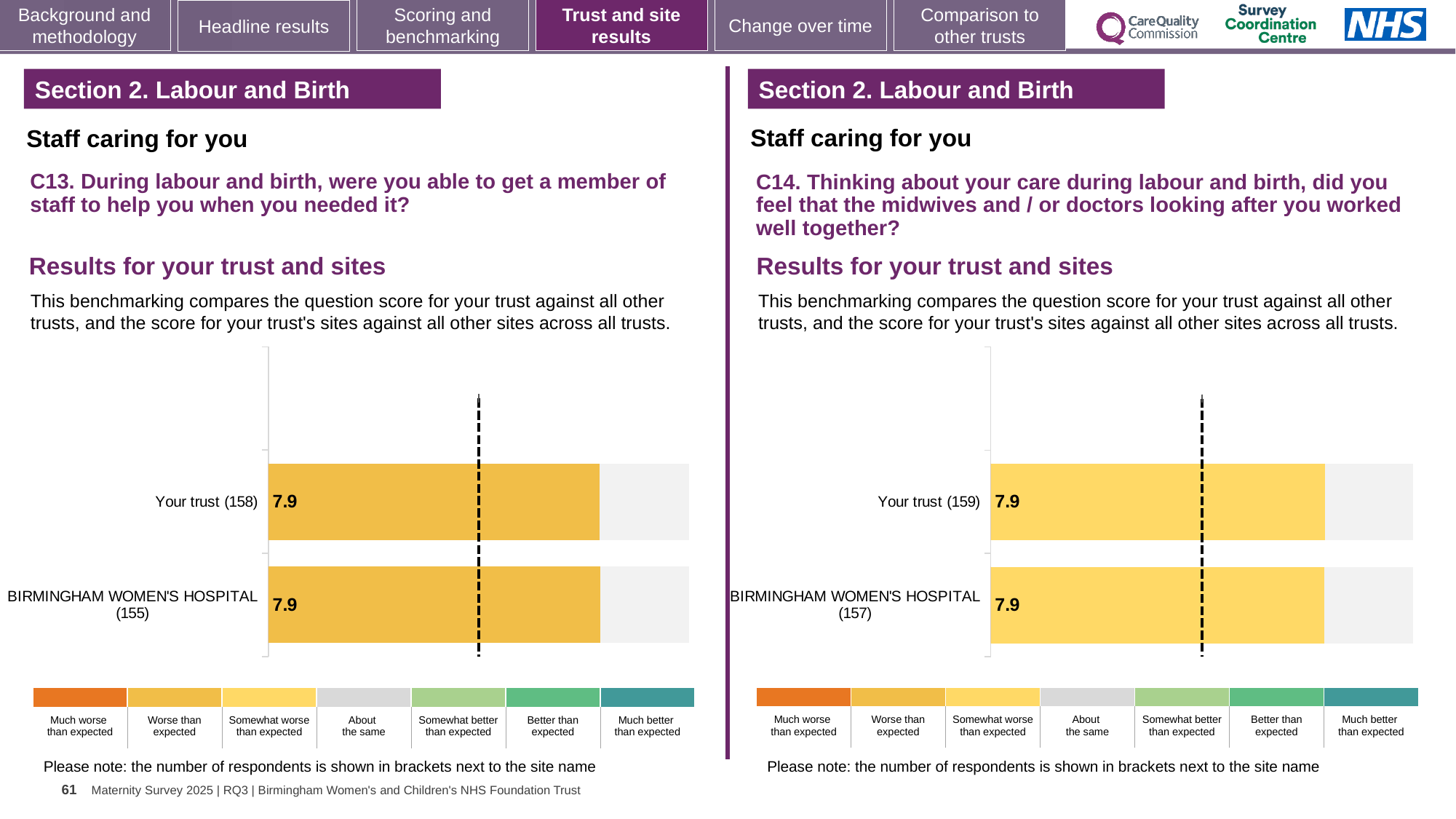
On the C14 chart (right), what is the difference between the Your trust score and the BIRMINGHAM WOMEN'S HOSPITAL score? 0 How many bars are plotted on the C14 chart (right)? 2 On the C14 chart (right), how many respondents are shown in brackets for BIRMINGHAM WOMEN'S HOSPITAL? 157 What type of chart is used on the C13 chart (left)? Bar chart How many categories does the colour legend below the C14 chart (right) list? 7 On the C13 chart (left), what is the score for Your trust? 7.9 On the C13 chart (left), how many respondents are shown in brackets for Your trust? 158 On the C14 chart (right), what is the score for Your trust? 7.9 On the C13 chart (left), what is the difference between the Your trust score and the BIRMINGHAM WOMEN'S HOSPITAL score? 0 On the C13 chart (left), what is the score for BIRMINGHAM WOMEN'S HOSPITAL? 7.9 On the C14 chart (right), what is the score for BIRMINGHAM WOMEN'S HOSPITAL? 7.9 How many bars are plotted on the C13 chart (left)? 2